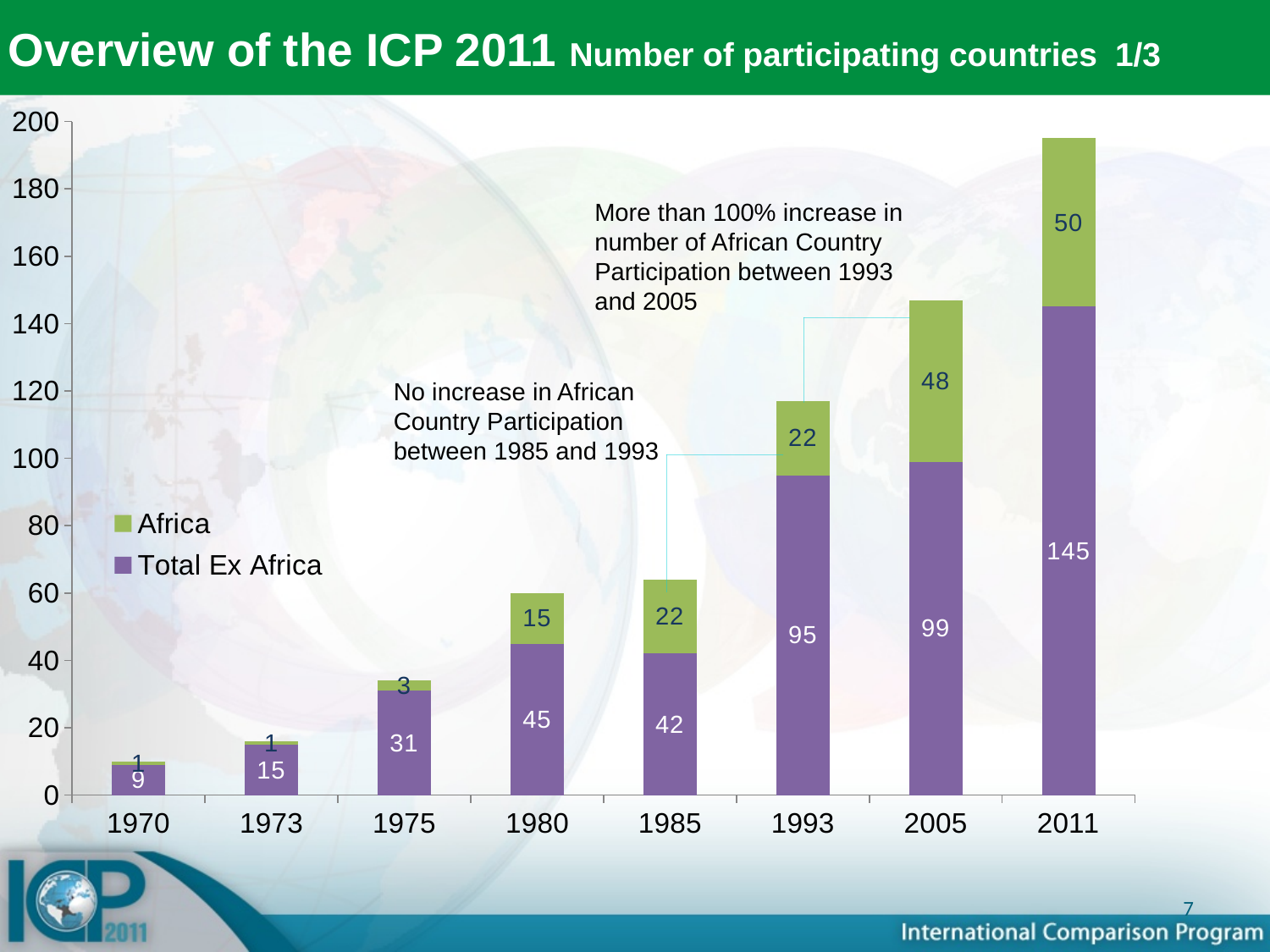
Which is larger, the Total Ex Africa value for 1980 or for 1985? 1980 Which year has the highest Total Ex Africa value? 2011 What is the Africa value for 2005? 48 Is the total height of the 2011 bar greater or less than 180? greater How many series does the legend list? 2 What is the Total Ex Africa value for 2011? 145 What kind of chart is shown on the slide? Stacked bar chart What is the difference between the Africa values for 2011 and 2005? 2 What is the Africa value for 1980? 15 What is the total number of participating countries in 2005 (Africa plus Total Ex Africa)? 147 Which year has the lowest Total Ex Africa value? 1970 How many years are shown on the x axis? 8